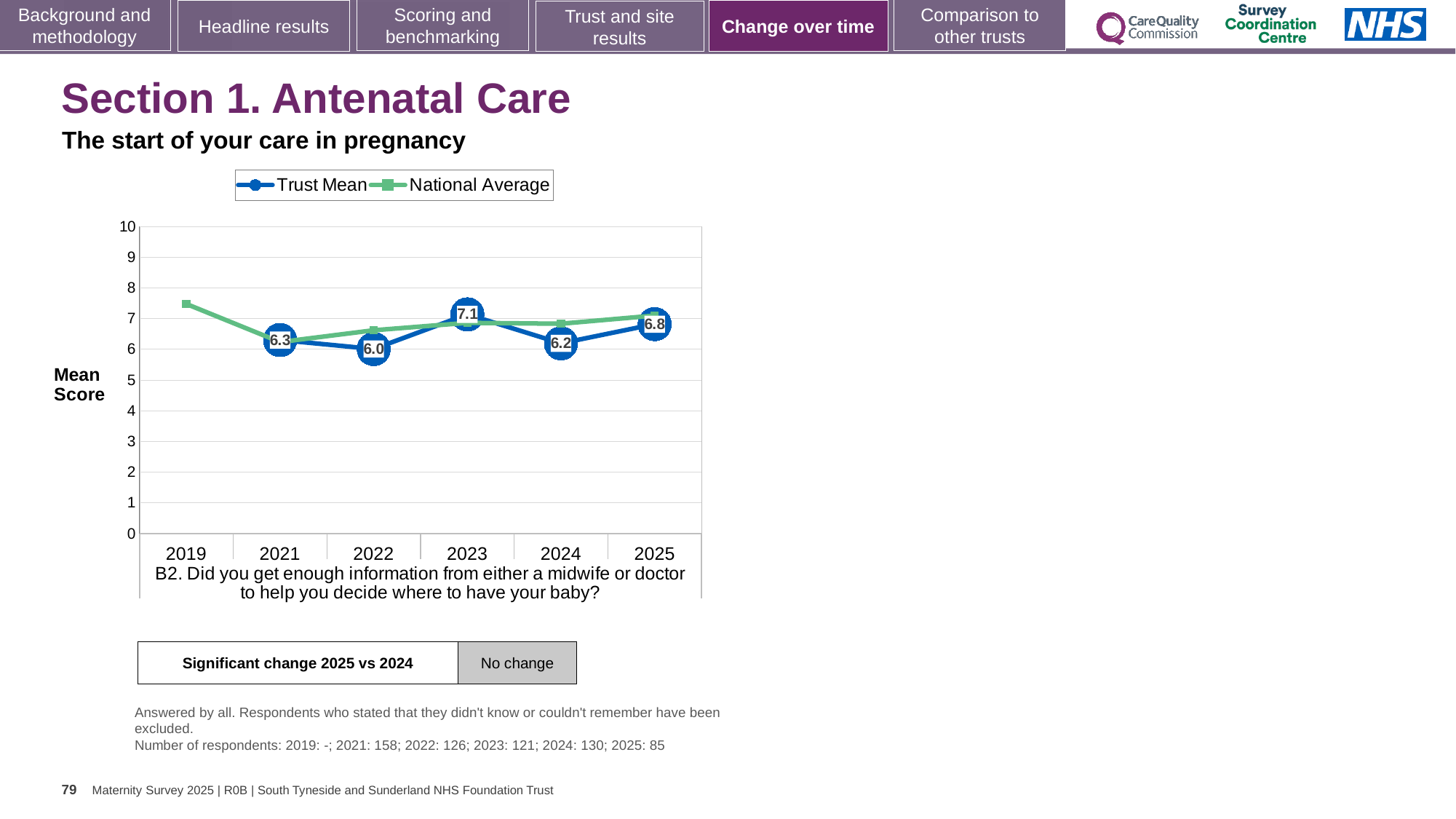
Is the National Average value for 2019 greater or less than 7? greater What kind of chart is shown on the slide? Line chart How many series does the legend list? 2 Did the Trust Mean rise or fall from 2024 to 2025? Rise What is the difference between the Trust Mean in 2023 and in 2022? 1.1 Which is larger, the Trust Mean for 2021 or for 2024? 2021 What is the Trust Mean value for 2025? 6.8 What is the Trust Mean value for 2023? 7.1 In which year is the Trust Mean lowest? 2022 How many years are shown on the x axis? 6 In which year is the Trust Mean highest? 2023 What is the Trust Mean value for 2022? 6.0